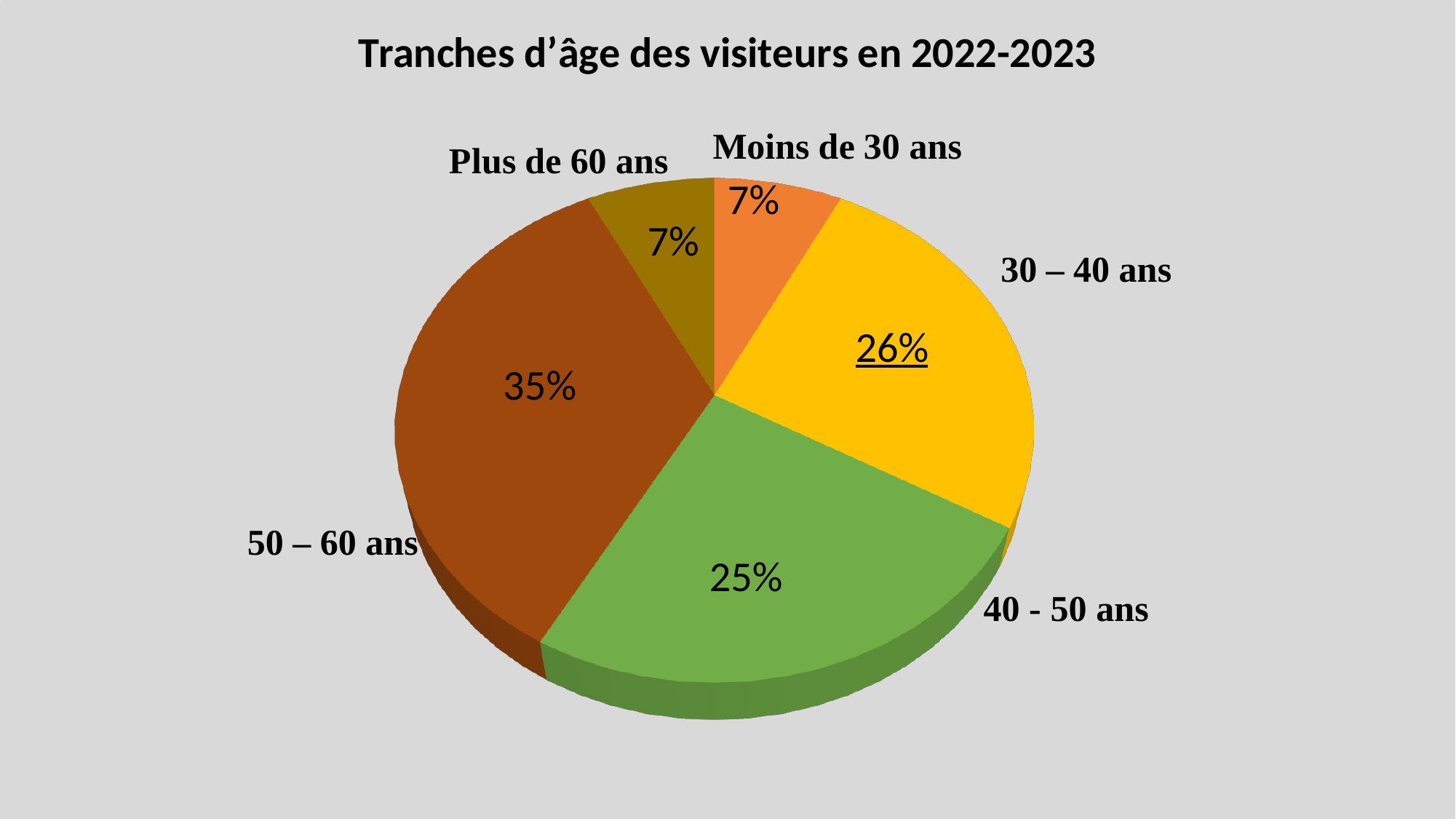
How many age groups are shown in the pie chart? 5 What kind of chart is shown on the slide? Pie chart What share of visitors were aged 30 – 40 ans? 26% What is the title of the chart? Tranches d’âge des visiteurs en 2022-2023 Which is larger, the share for 30 – 40 ans or the share for Plus de 60 ans? 30 – 40 ans What share of visitors were Moins de 30 ans? 7% What share of visitors were aged 40 - 50 ans? 25% What share of visitors were Plus de 60 ans? 7% Which age group has the largest share of visitors? 50 – 60 ans What colour is the slice for 40 - 50 ans? Green What is the difference in percentage points between the 50 – 60 ans slice and the 40 - 50 ans slice? 10 What share of visitors were aged 50 – 60 ans? 35%